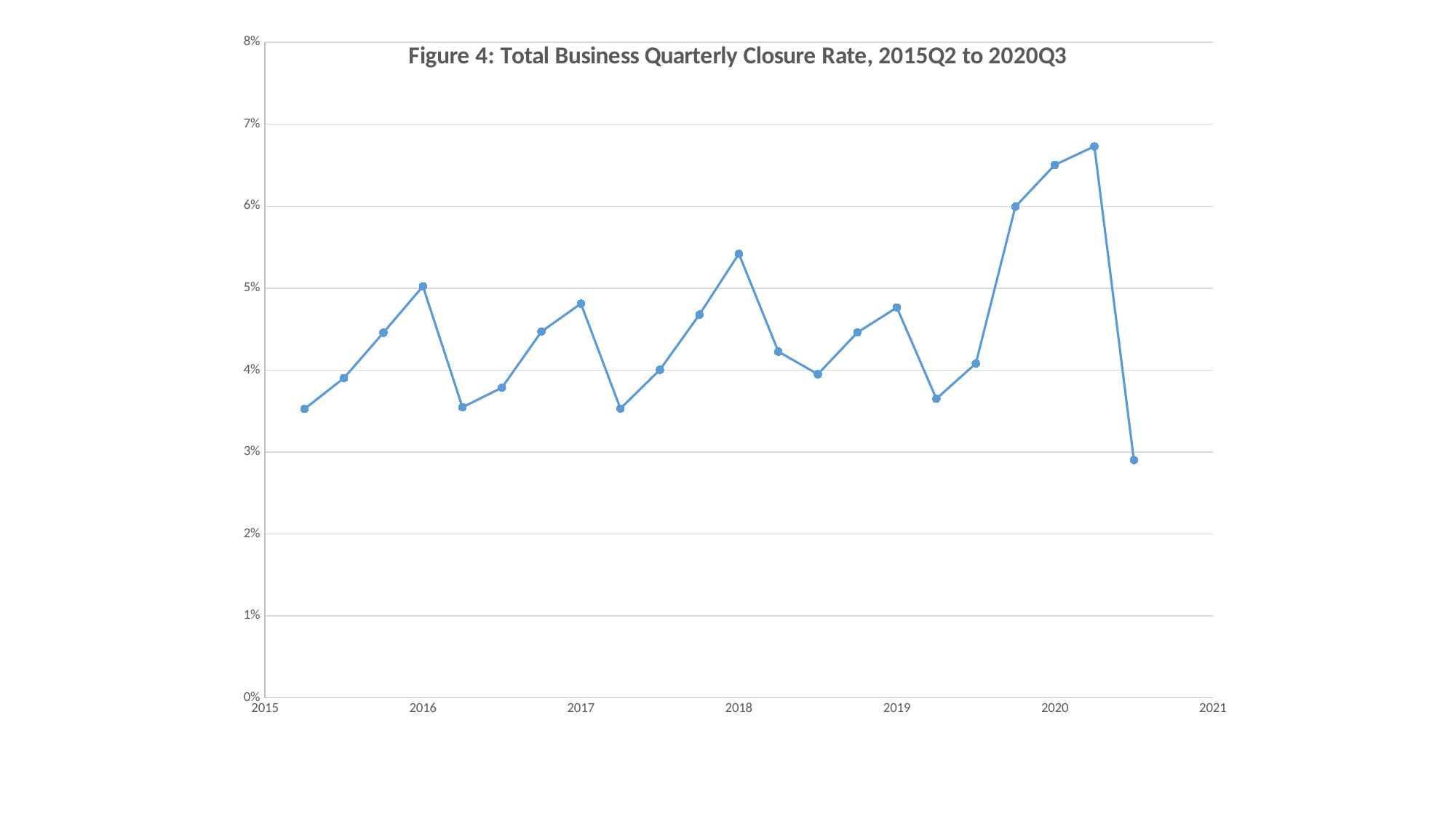
Is the value of the first plotted point (2015Q2) greater or less than 3%? greater Which is larger: the value at the 2018 tick mark or the value at the 2017 tick mark? 2018 Among the points that fall on the year tick marks (2016 through 2020), which year has the highest closure rate? 2020 What kind of chart is shown on the slide? line chart Does the line rise or fall between the 2020 tick mark and the final point? fall Is the value of the point at the 2018 tick mark greater or less than 5%? greater How many data points are plotted on the line? 22 Is the value of the last plotted point (2020Q3) greater or less than 3%? less What is the title of the chart? Figure 4: Total Business Quarterly Closure Rate, 2015Q2 to 2020Q3 Which is larger: the first plotted point (2015Q2) or the last plotted point (2020Q3)? 2015Q2